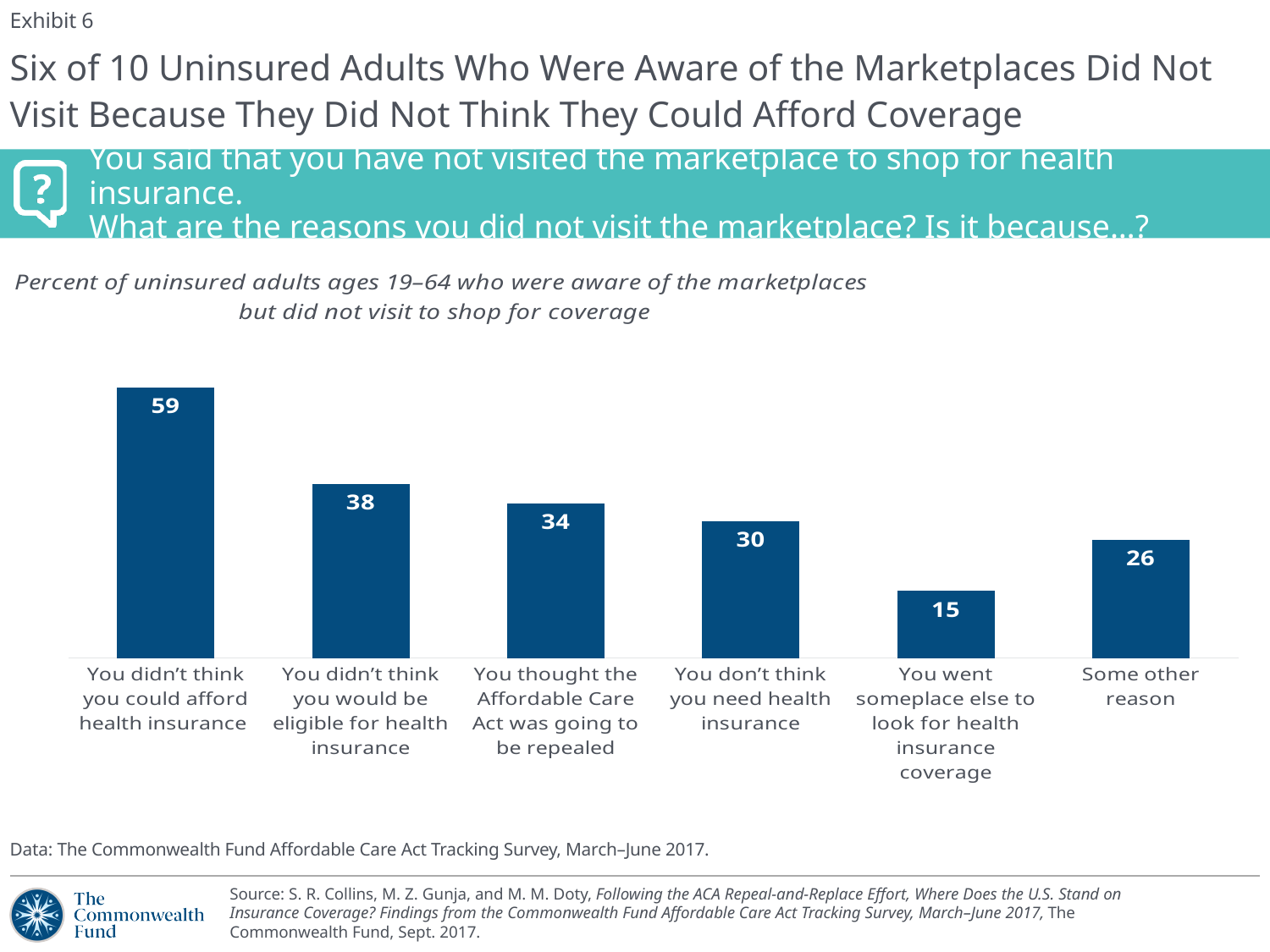
What is the difference between 'You didn't think you could afford health insurance' and 'You didn't think you would be eligible for health insurance'? 21 What is the value for 'Some other reason'? 26 Which reason has the highest percentage? You didn't think you could afford health insurance Which reason has the lowest percentage? You went someplace else to look for health insurance coverage What is the subtitle describing the population shown in the chart? Percent of uninsured adults ages 19–64 who were aware of the marketplaces but did not visit to shop for coverage What kind of chart is shown on the slide? Bar chart Which is larger: 'You don't think you need health insurance' or 'Some other reason'? You don't think you need health insurance How many reasons (categories) are shown in the chart? 6 What is the value for 'You thought the Affordable Care Act was going to be repealed'? 34 What is the value for 'You didn't think you would be eligible for health insurance'? 38 What percent of uninsured adults said they didn't think they could afford health insurance? 59 What is the difference between 'You don't think you need health insurance' and 'You went someplace else to look for health insurance coverage'? 15